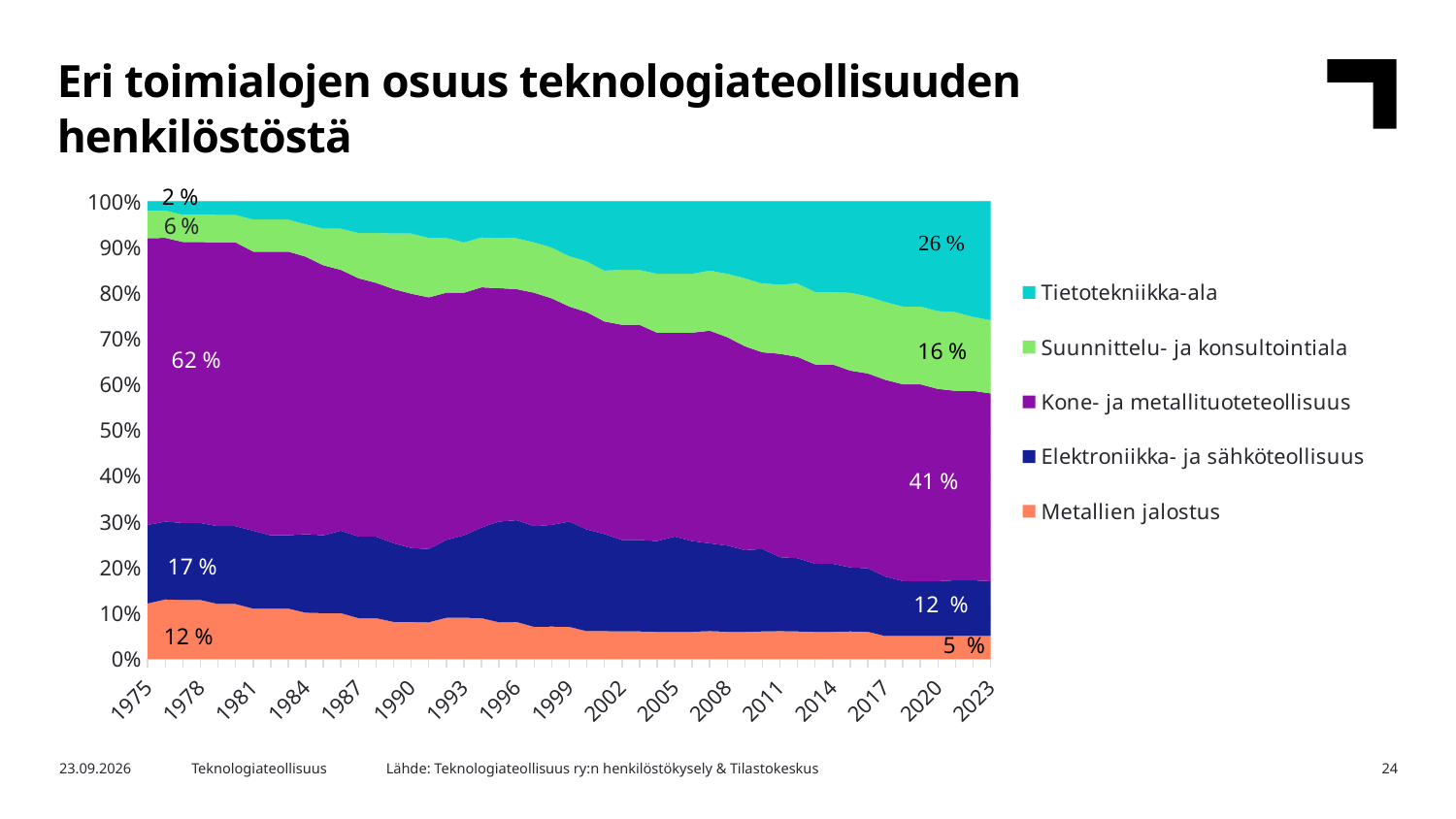
In 2023, which is larger: the share of Tietotekniikka-ala or the share of Suunnittelu- ja konsultointiala? Tietotekniikka-ala What share did Suunnittelu- ja konsultointiala have in 1975 according to the data label? 6 % How many series does the legend list? 5 What share of technology industry personnel did Kone- ja metallituoteteollisuus have in 1975 according to the data label? 62 % Does the share of Tietotekniikka-ala rise or fall from 1975 to 2023? Rise By how many percentage points did the share of Kone- ja metallituoteteollisuus change between the 1975 label (62 %) and the 2023 label (41 %)? 21 percentage points What kind of chart is shown on the slide? Stacked area chart What share does Metallien jalostus have in 2023 according to the data label? 5 % What share does Tietotekniikka-ala have at the end of the series (2023) according to the data label? 26 % What is the title of the chart on the slide? Eri toimialojen osuus teknologiateollisuuden henkilöstöstä Which sector had the smallest share in 1975? Tietotekniikka-ala Which sector had the largest share in 1975? Kone- ja metallituoteteollisuus